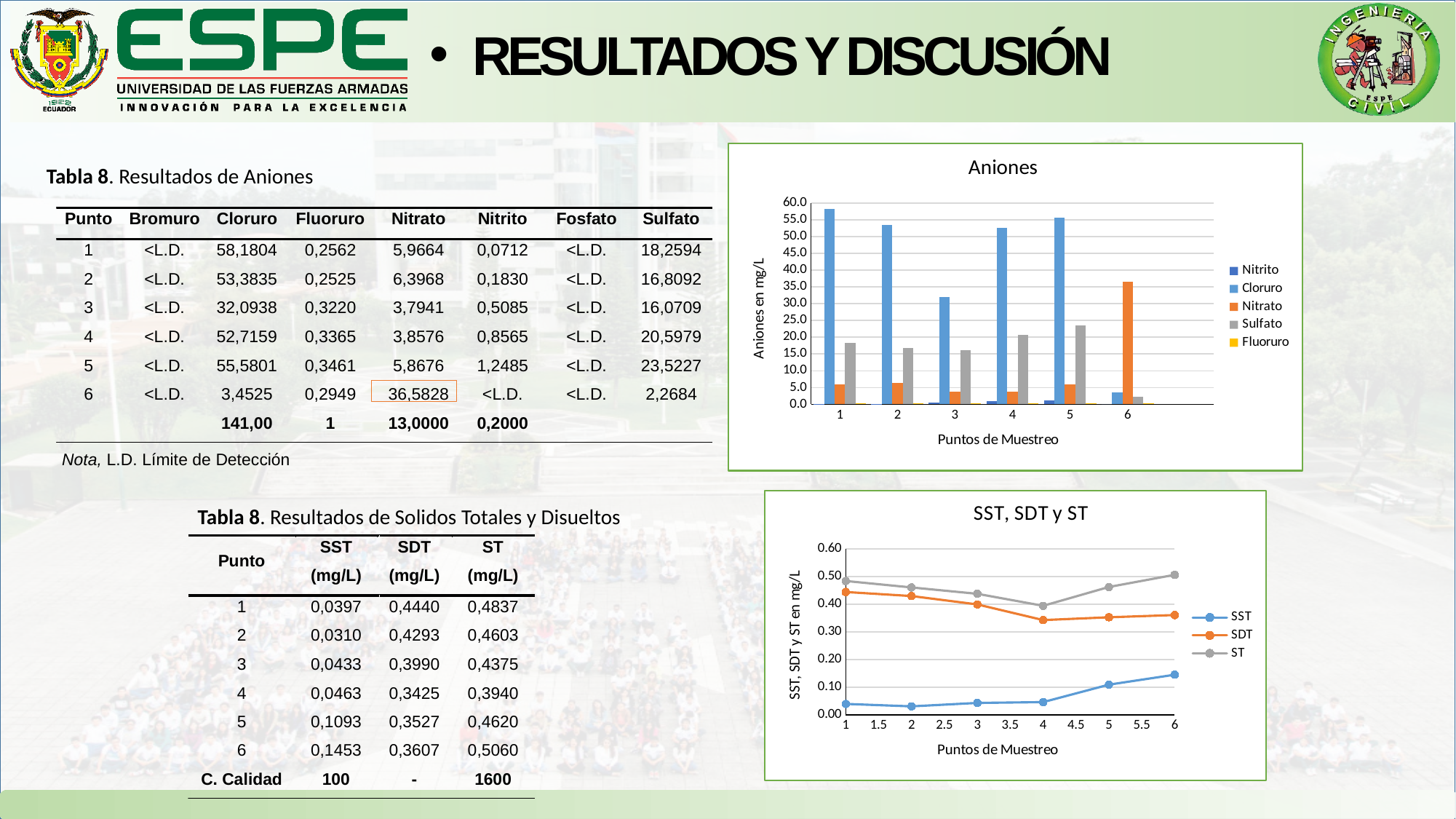
In the "Aniones" chart, at which sampling point is the Cloruro bar lowest? 6 In the "SST, SDT y ST" chart, does the SST line rise or fall from sampling point 4 to sampling point 6? rise In the "Aniones" chart, at sampling point 6, which is larger: Nitrato or Cloruro? Nitrato What kind of chart is the "Aniones" chart? bar chart How many series does the legend of the "Aniones" chart list? 5 What kind of chart is the "SST, SDT y ST" chart? line chart How many sampling points are shown on the x axis of the "Aniones" chart? 6 In the "Aniones" chart, is the Cloruro value at sampling point 3 greater or less than 35.0? less How many series does the legend of the "SST, SDT y ST" chart list? 3 In the "Aniones" chart, is the Nitrato value at sampling point 6 greater or less than 35.0? greater In the "Aniones" chart, at which sampling point is the Cloruro bar highest? 1 In the "SST, SDT y ST" chart, at which sampling point is the ST line lowest? 4